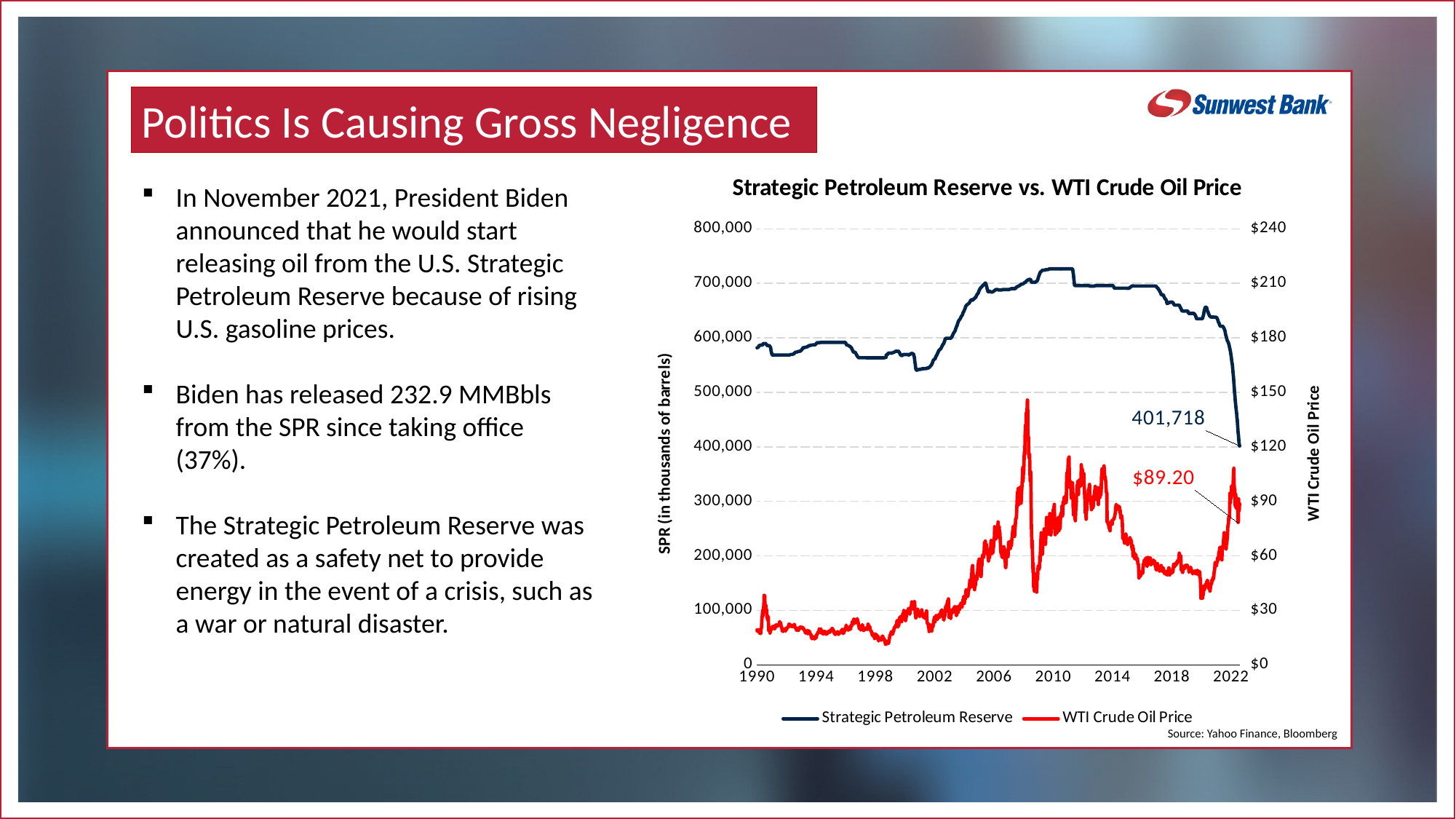
Is the Strategic Petroleum Reserve value in 2010 greater or less than 600,000? greater How many series does the chart legend list? 2 What is the title of the chart? Strategic Petroleum Reserve vs. WTI Crude Oil Price What is the latest labeled value of the Strategic Petroleum Reserve series? 401,718 Does the WTI Crude Oil Price series rise or fall between 2002 and 2008? rise Is the peak WTI Crude Oil Price around 2008 greater or less than $120? greater Is the Strategic Petroleum Reserve value in 1990 greater or less than 700,000? less Does the Strategic Petroleum Reserve series rise or fall between 2018 and 2022? fall What is the latest labeled value of the WTI Crude Oil Price series? $89.20 Which series is drawn in red? WTI Crude Oil Price What type of chart is shown on the slide? line chart